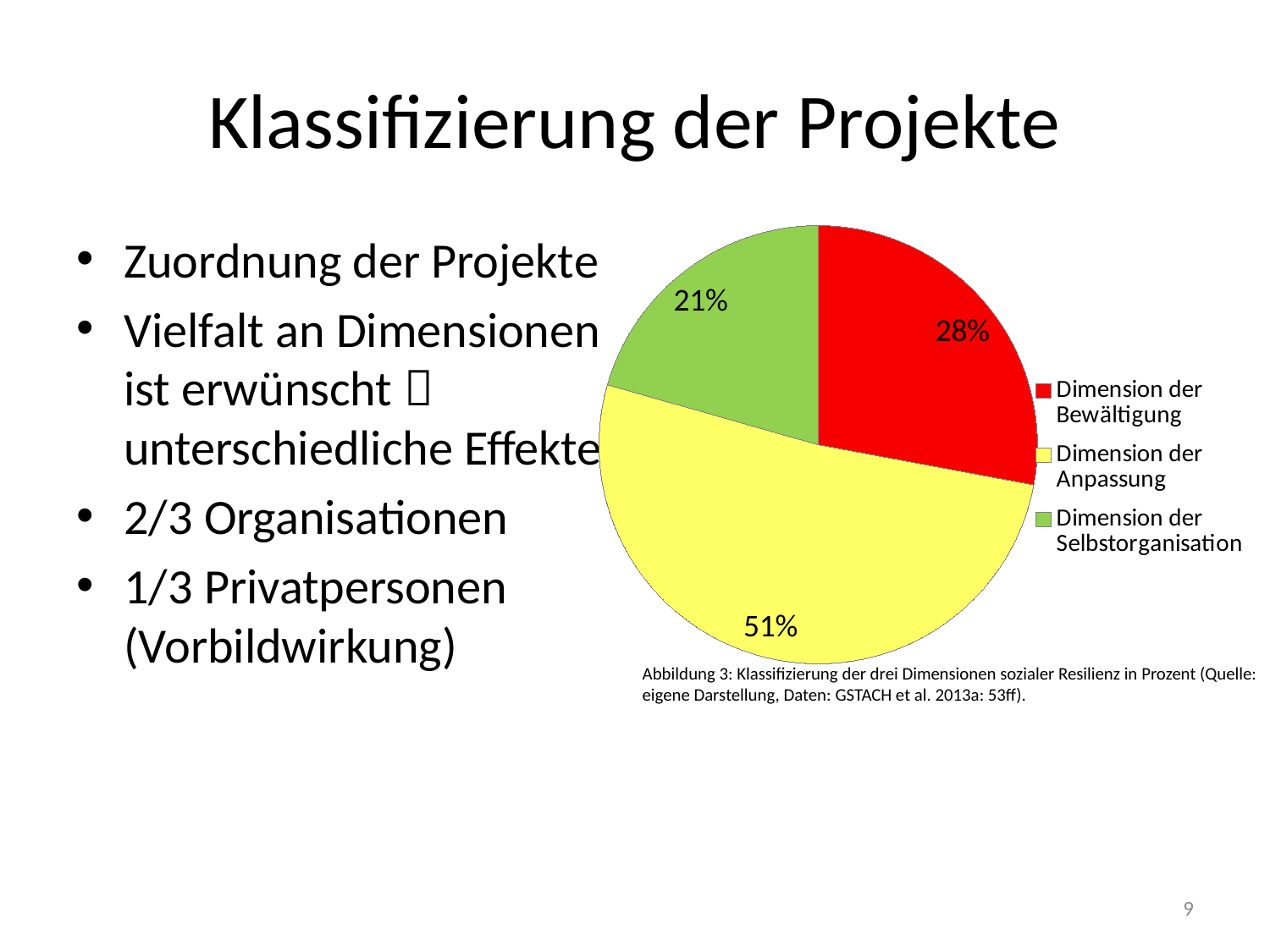
What share of the pie does "Dimension der Bewältigung" have? 28% What kind of chart is shown on the slide? pie chart How many slices does the pie chart have? 3 What colour is the slice for "Dimension der Anpassung"? yellow Which dimension has the smallest slice of the pie? Dimension der Selbstorganisation What share of the pie does "Dimension der Selbstorganisation" have? 21% How many entries does the legend list? 3 Which dimension has the largest slice of the pie? Dimension der Anpassung What is the difference in percentage points between "Dimension der Anpassung" and "Dimension der Bewältigung"? 23 percentage points What share of the pie does "Dimension der Anpassung" have? 51% What colour is the slice for "Dimension der Bewältigung"? red Which is larger: the slice for "Dimension der Bewältigung" or the slice for "Dimension der Selbstorganisation"? Dimension der Bewältigung